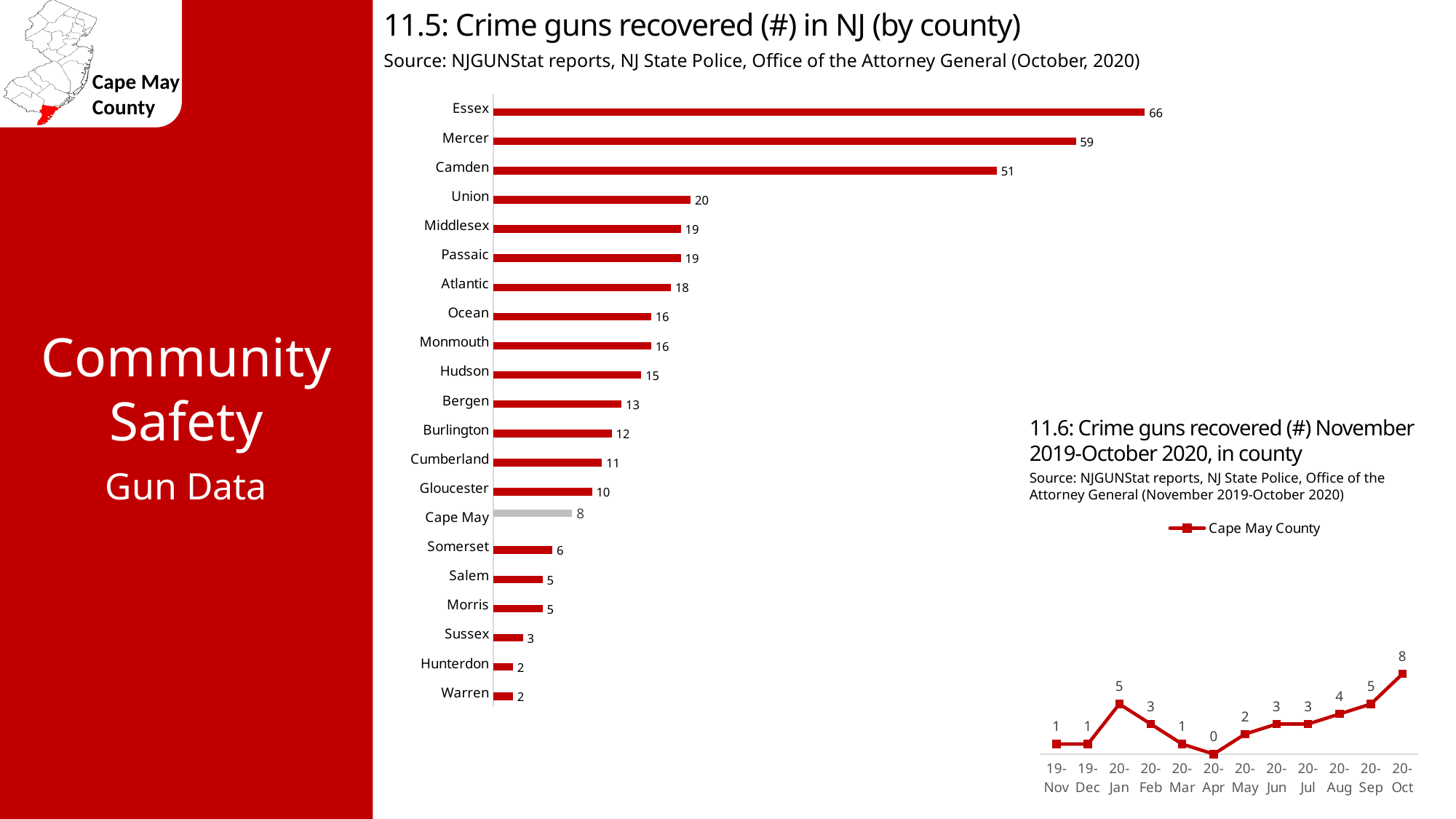
In chart 11.5 (crime guns recovered by county), which bar is shown in grey rather than red? Cape May In chart 11.5 (crime guns recovered by county), which county has the highest number of crime guns recovered? Essex In chart 11.5 (crime guns recovered by county), what is the value for Cape May? 8 In chart 11.6 (crime guns recovered November 2019-October 2020), what is the value for 20-Oct? 8 In chart 11.6 (crime guns recovered November 2019-October 2020), which month has the lowest value? 20-Apr In chart 11.6 (crime guns recovered November 2019-October 2020), how many data points are plotted? 12 In chart 11.5 (crime guns recovered by county), which is larger, Union or Gloucester? Union What kind of chart is chart 11.5 (crime guns recovered by county)? Bar chart In chart 11.6 (crime guns recovered November 2019-October 2020), what series does the legend list? Cape May County In chart 11.5 (crime guns recovered by county), what is the difference between Mercer and Camden? 8 In chart 11.5 (crime guns recovered by county), how many crime guns were recovered in Essex? 66 In chart 11.5 (crime guns recovered by county), how many counties are shown? 21